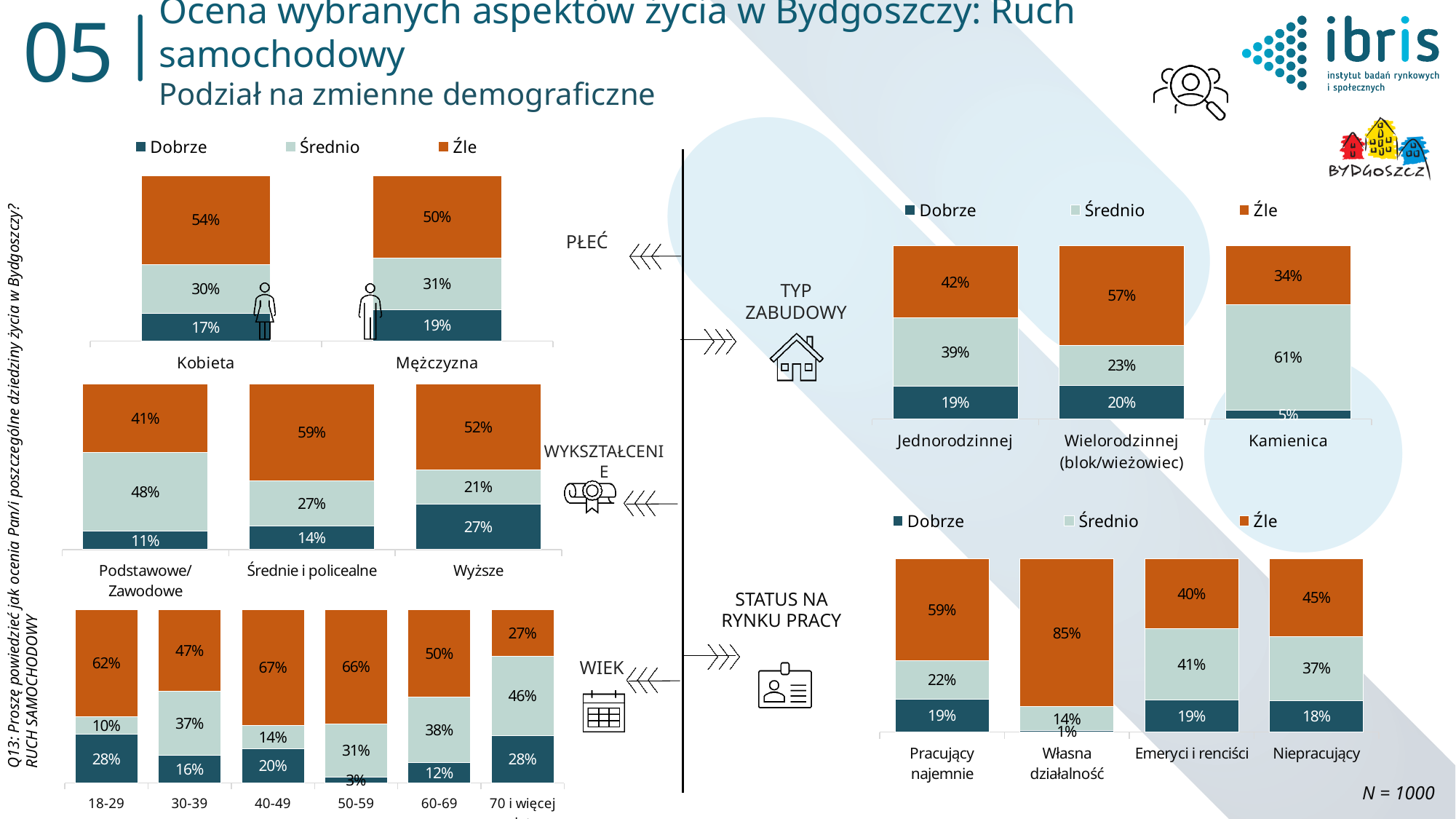
In the TYP ZABUDOWY (housing type) chart, what is the difference between the Źle values for Wielorodzinnej (blok/wieżowiec) and Jednorodzinnej? 15 percentage points In the STATUS NA RYNKU PRACY chart, which is larger: the Średnio value for Emeryci i renciści or for Niepracujący? Emeryci i renciści How many series does the legend of the PŁEĆ (gender) chart list? 3 In the WIEK (age) chart, how many age groups are shown? 6 In the STATUS NA RYNKU PRACY chart, which category has the highest Źle share? Własna działalność In the PŁEĆ (gender) chart, what percentage of women (Kobieta) rated car traffic as Źle? 54% In the WIEK (age) chart, what is the Źle value for the 40-49 group? 67% In the WIEK (age) chart, which age group has the lowest Dobrze share? 50-59 In the TYP ZABUDOWY (housing type) chart, what is the Średnio value for Kamienica? 61% In the WYKSZTAŁCENIE (education) chart, what is the Średnio value for Podstawowe/Zawodowe? 48% In the WYKSZTAŁCENIE (education) chart, which category has the highest Dobrze share? Wyższe In the PŁEĆ (gender) chart, what is the Dobrze value for Mężczyzna? 19%